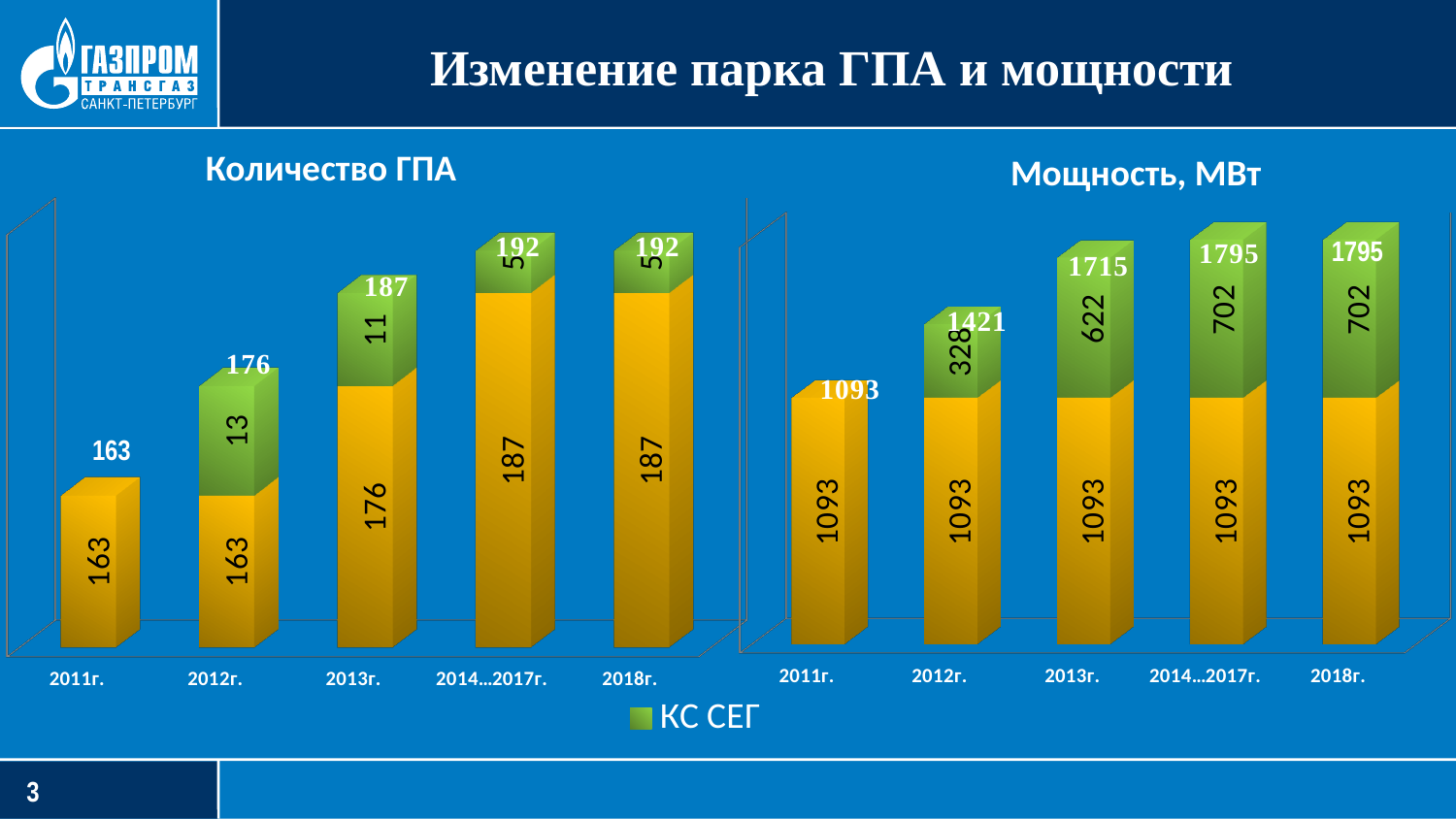
In the chart titled "Мощность, МВт", what is the value of the green КС СЕГ segment for 2012г.? 328 In the chart titled "Количество ГПА", what is the value of the green КС СЕГ segment for 2013г.? 11 What kind of chart is the chart titled "Мощность, МВт"? stacked bar chart How many year categories are shown on the x axis of the chart titled "Количество ГПА"? 5 In the chart titled "Мощность, МВт", what is the total value shown above the bar for 2013г.? 1715 In the chart titled "Количество ГПА", what is the difference between the total for 2018г. and the total for 2011г.? 29 What is the only entry shown in the legend below the charts? КС СЕГ In the chart titled "Мощность, МВт", which year has the lowest total value? 2011г. In the chart titled "Количество ГПА", what is the total value shown above the bar for 2012г.? 176 In the chart titled "Мощность, МВт", what is the difference between the green КС СЕГ segment for 2018г. and the green segment for 2013г.? 80 In the chart titled "Количество ГПА", what is the value of the yellow segment for 2014…2017г.? 187 In the chart titled "Мощность, МВт", is the total for 2012г. larger or smaller than the total for 2013г.? smaller